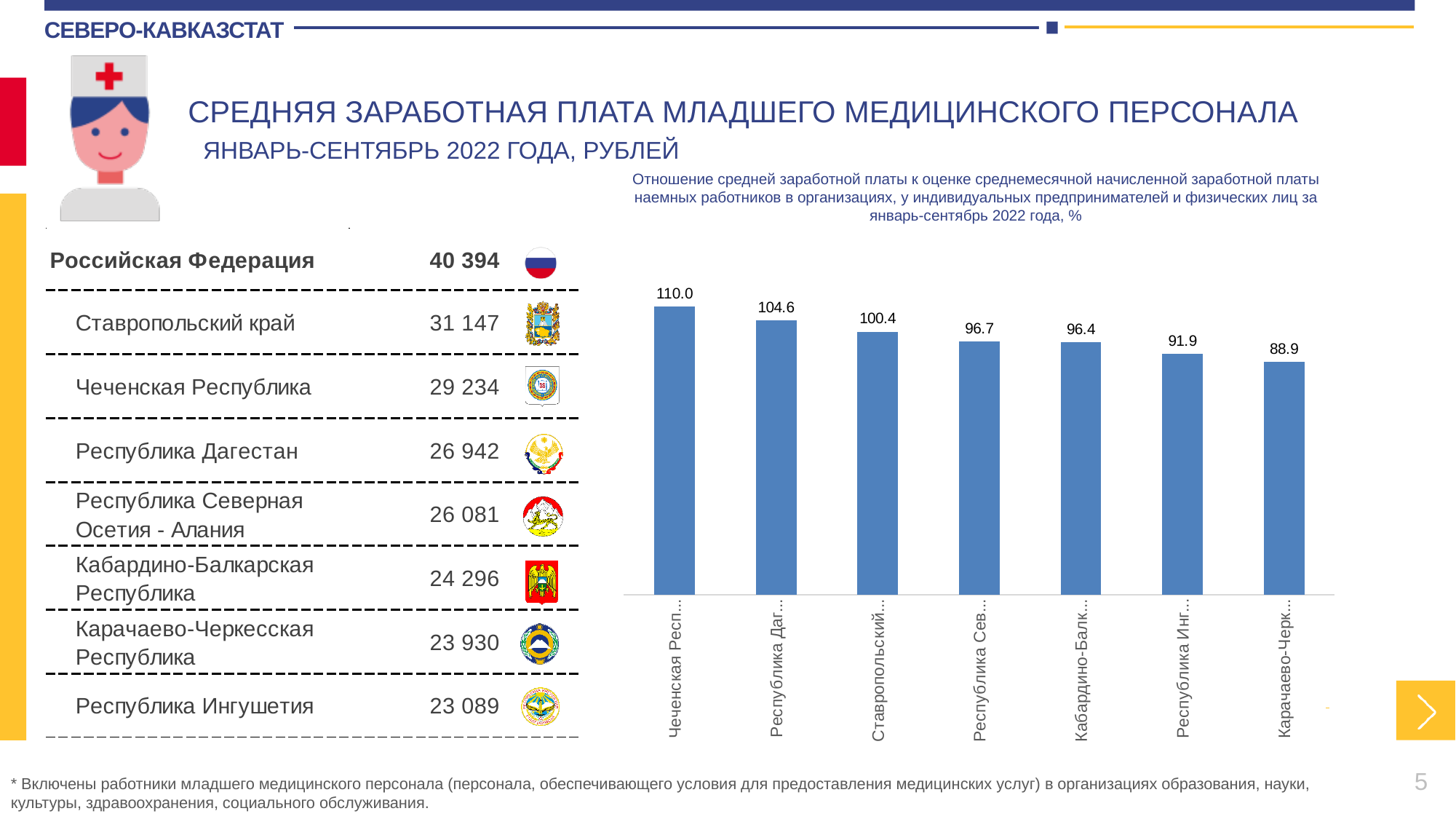
What is the value shown for Карачаево-Черкесская Республика in the chart? 88.9 How many bars (regions) are plotted in the chart? 7 Which region has the highest value in the chart? Чеченская Республика Which region has the lowest value in the chart? Карачаево-Черкесская Республика What is the value shown for Чеченская Республика in the chart? 110.0 What is the value shown for Республика Дагестан in the chart? 104.6 What type of chart is shown on the slide? bar chart Which is larger in the chart: the value for Ставропольский край or the value for Республика Ингушетия? Ставропольский край Do the bar values rise or fall from left to right across the chart? fall What is the difference between the values for Республика Дагестан and Республика Ингушетия in the chart? 12.7 What is the difference between the values for Чеченская Республика and Карачаево-Черкесская Республика in the chart? 21.1 What is the value shown for Ставропольский край in the chart? 100.4